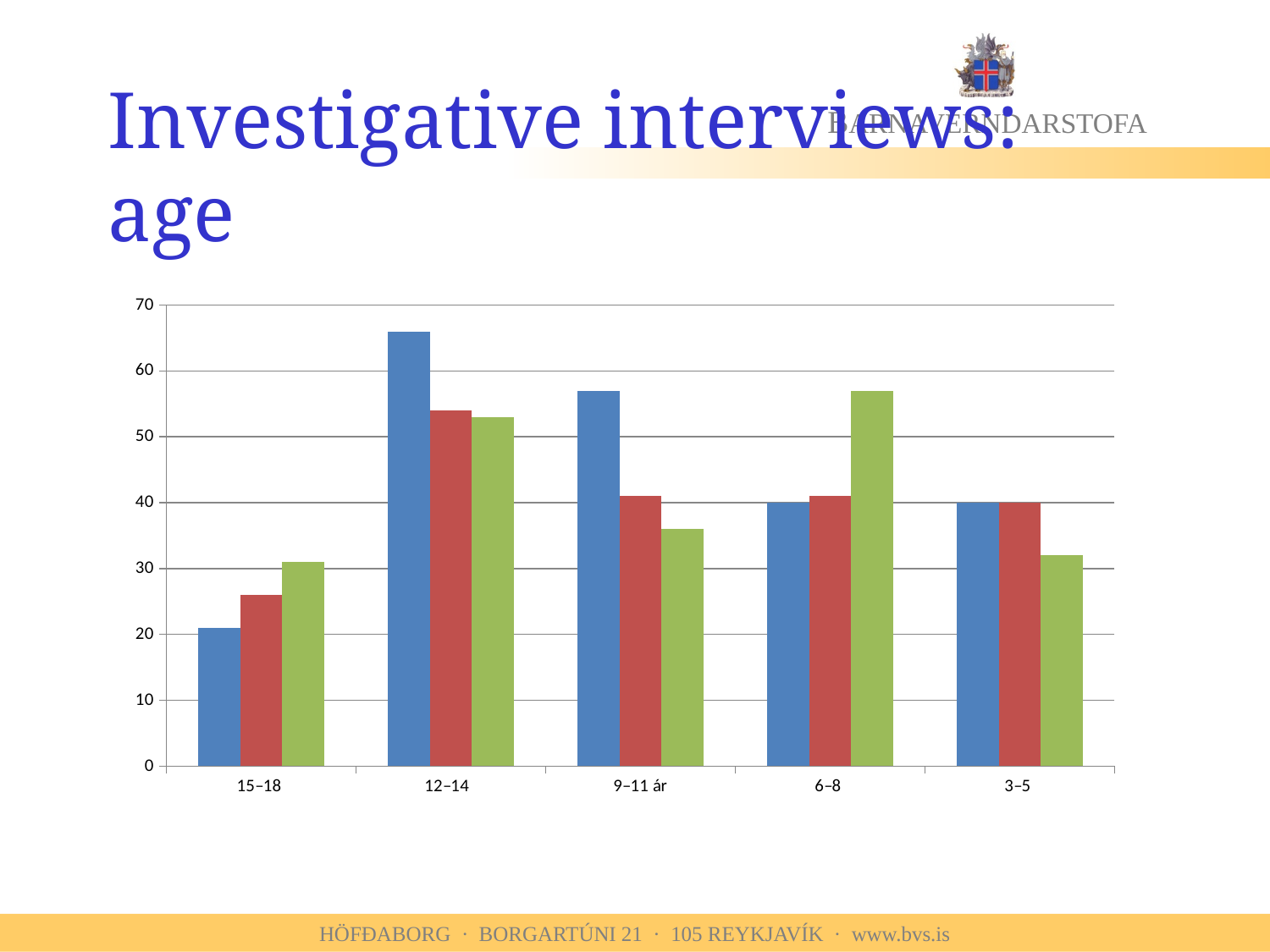
How many age categories are shown on the x axis? 5 Which is larger: the blue bar for 12–14 or the blue bar for 9–11 ár? 12–14 Which colour bar is the tallest in the 6–8 age category? green How many bars are shown for the 15–18 age category? 3 What is the value of the blue bar for the 6–8 age category? 40 Which age category has the tallest blue bar? 12–14 Which age category has the shortest blue bar? 15–18 Is the blue bar for the 12–14 age category greater or less than 60? greater Is the green bar for the 6–8 age category greater or less than 50? greater Is the blue bar for the 15–18 age category greater or less than 30? less What is the value of the red bar for the 3–5 age category? 40 What type of chart is shown on the slide? bar chart